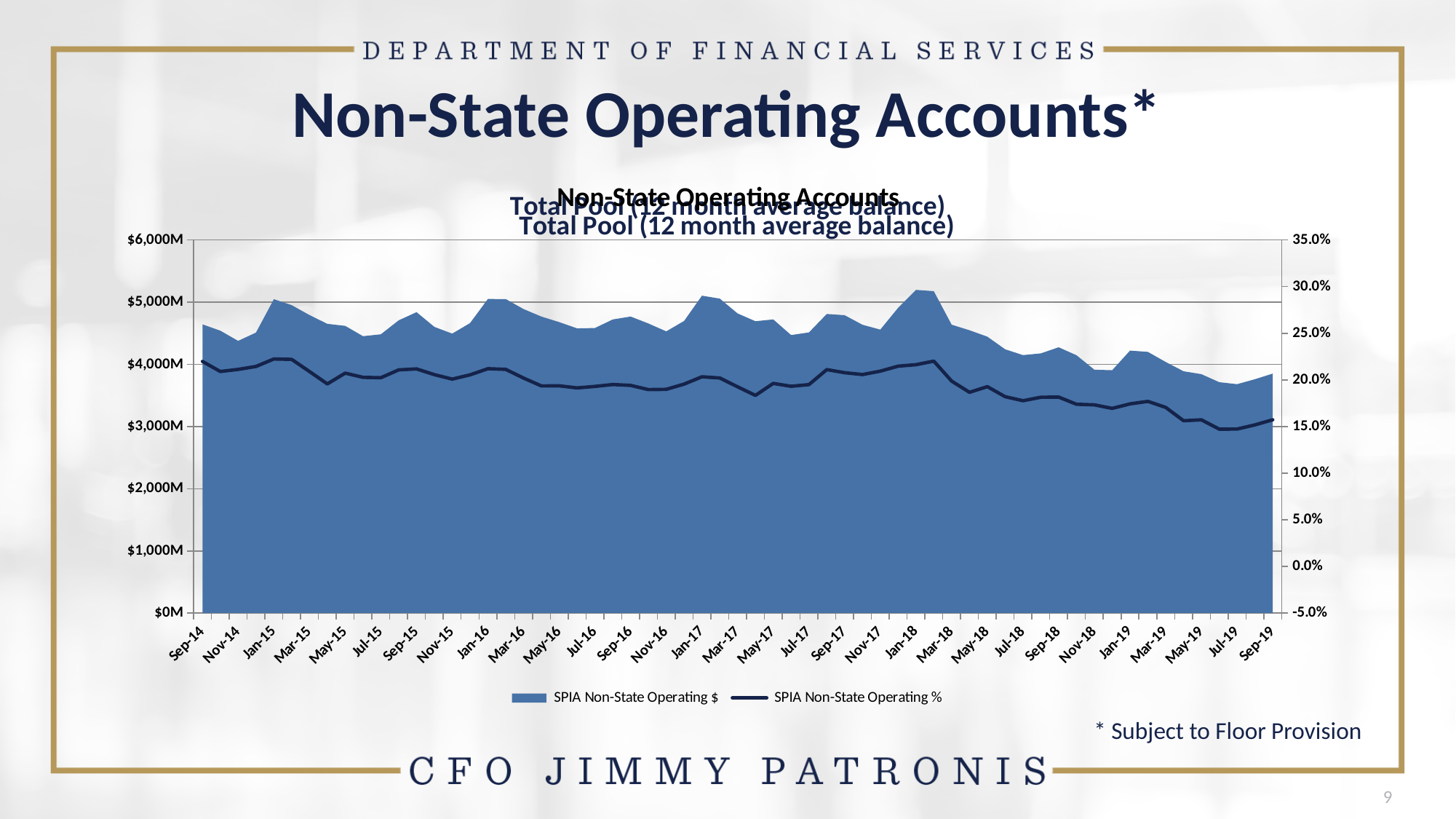
Does the SPIA Non-State Operating % line generally rise or fall from Sep-14 to Sep-19? fall Is the SPIA Non-State Operating $ value for Sep-14 greater or less than $4,000M? greater Is the SPIA Non-State Operating % value for Sep-19 greater or less than 20.0%? less What is the highest value shown on the right-hand percentage axis? 35.0% Is the SPIA Non-State Operating $ value for Jul-19 greater or less than $4,000M? less Which month shows the highest SPIA Non-State Operating $ balance? Jan-18 Which is larger, the SPIA Non-State Operating $ value for Sep-14 or for Sep-19? Sep-14 What are the two series named in the legend? SPIA Non-State Operating $ and SPIA Non-State Operating % How many series does the legend list? 2 What kind of chart is shown on the slide? An area chart with a line overlay